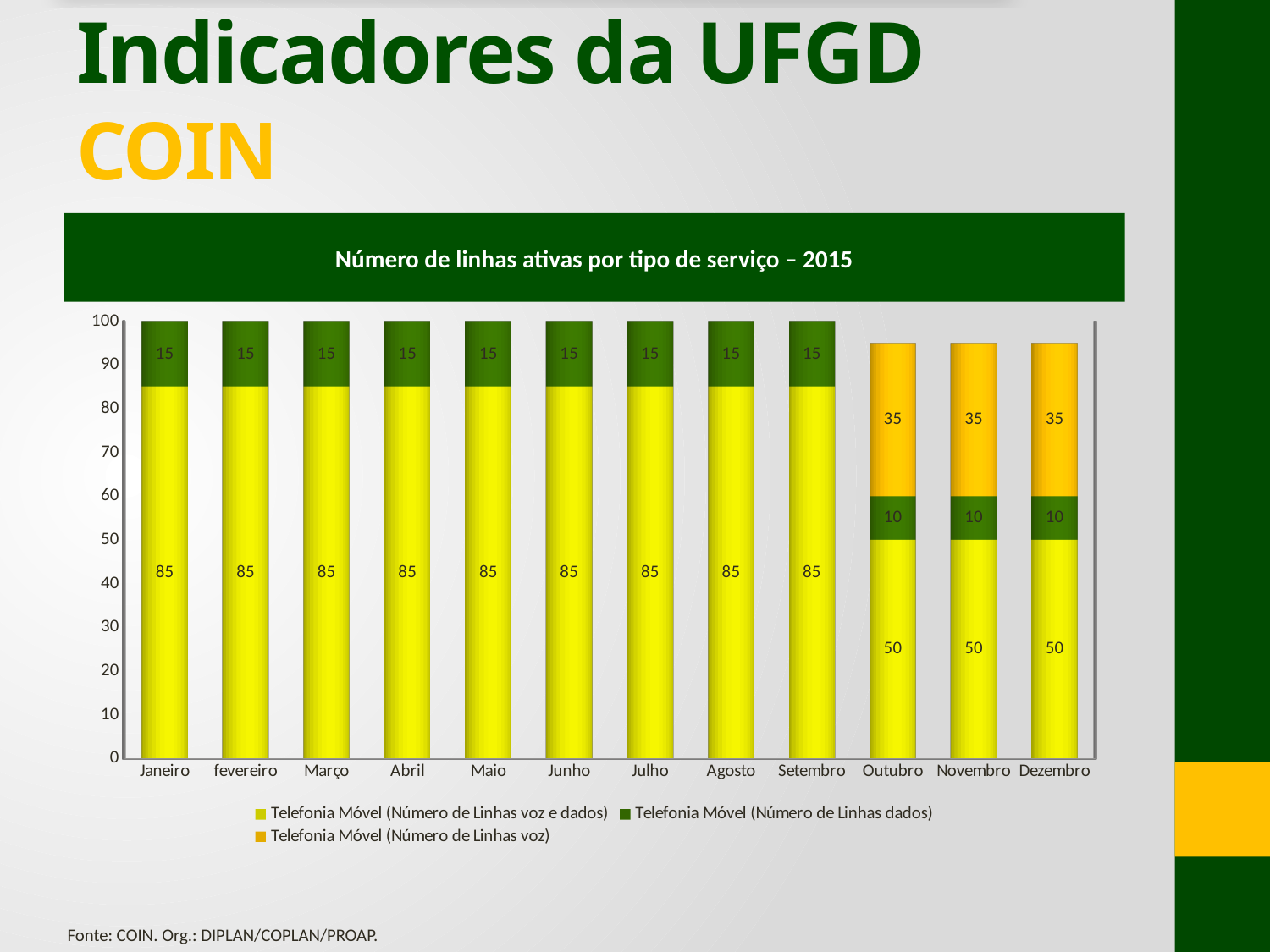
What type of chart is shown on the slide? stacked bar chart What is the title of the chart? Número de linhas ativas por tipo de serviço – 2015 Which is larger: the Telefonia Móvel (Número de Linhas dados) value for Agosto or for Dezembro? Agosto What is the total of the stacked bar for Outubro? 95 What is the difference between the Telefonia Móvel (Número de Linhas voz e dados) value for Setembro and for Outubro? 35 What is the value of Telefonia Móvel (Número de Linhas voz e dados) for Dezembro? 50 What is the value of Telefonia Móvel (Número de Linhas voz e dados) for Janeiro? 85 How many months are shown on the x axis? 12 What is the total of the stacked bar for Março? 100 What is the value of Telefonia Móvel (Número de Linhas dados) for Maio? 15 How many series does the legend list? 3 What is the value of Telefonia Móvel (Número de Linhas voz) for Novembro? 35